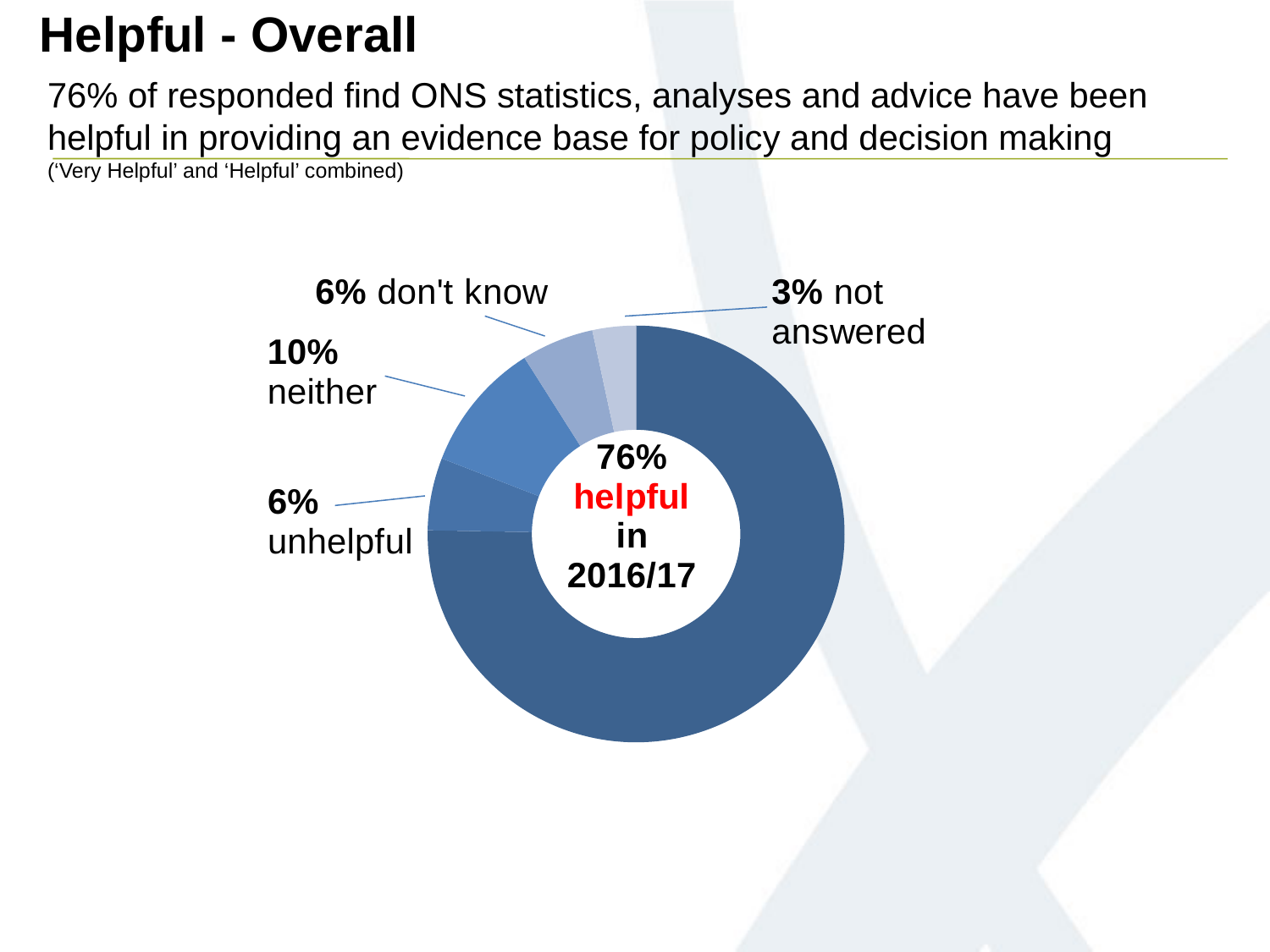
Which category has the largest share of the chart? helpful What share of respondents found ONS statistics helpful in 2016/17? 76% Which is larger, the share for 'neither' or the share for 'unhelpful'? neither What percentage of respondents answered 'don't know'? 6% What percentage of respondents did not answer? 3% What is the title of the slide? Helpful - Overall Which category has the smallest share of the chart? not answered What kind of chart is shown on the slide? pie chart (doughnut) How many categories are shown in the chart? 5 What is the difference in percentage points between 'helpful' and 'neither'? 66 What percentage of respondents answered 'unhelpful'? 6% What percentage of respondents answered 'neither'? 10%